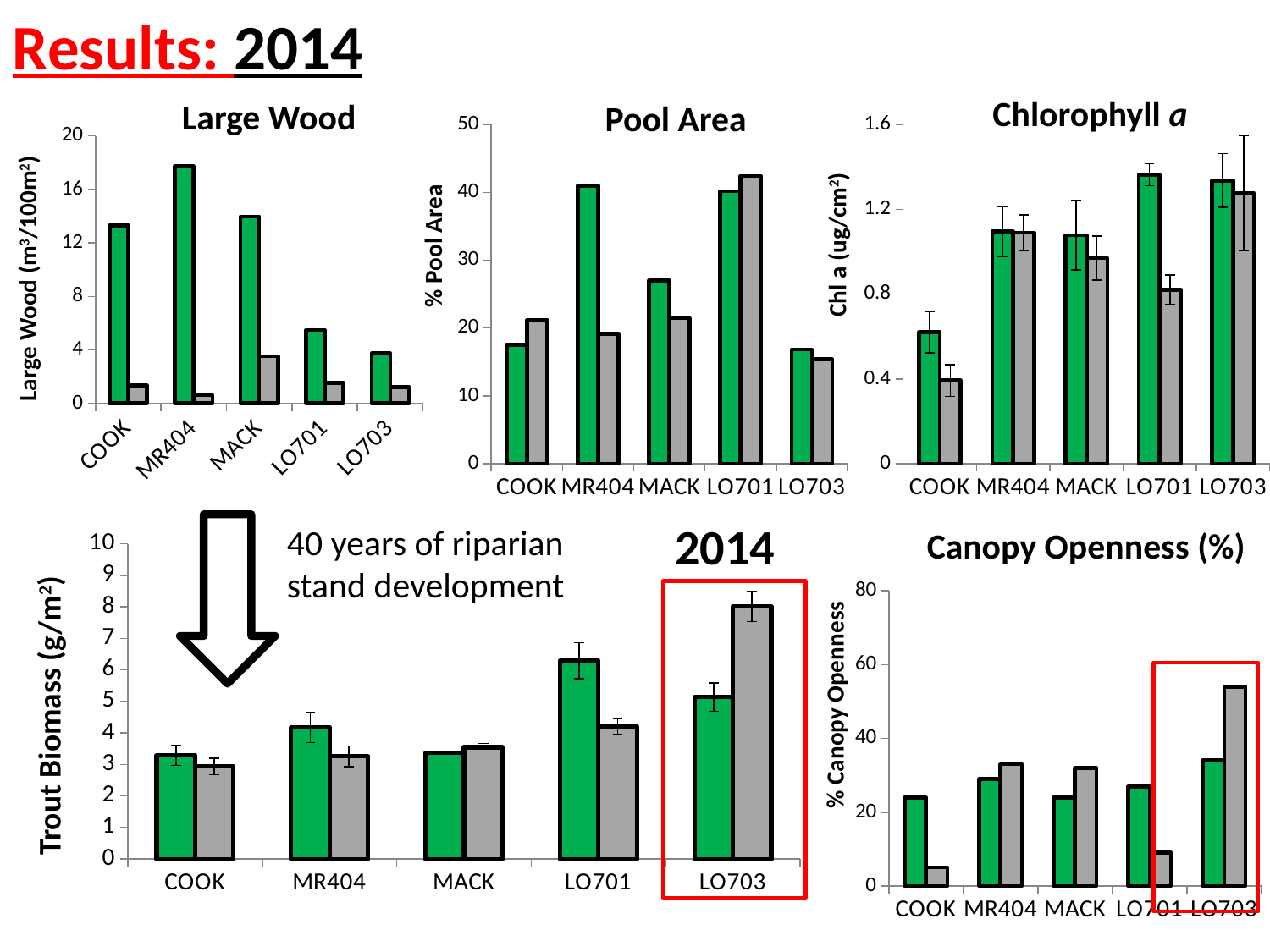
In the Canopy Openness (%) chart, which category has the lowest gray bar? COOK In the Canopy Openness (%) chart, is the gray bar for LO703 greater or less than 40? greater In the Large Wood chart, how many categories are shown on the x axis? 5 In the Chlorophyll a chart, is the green bar for LO701 greater or less than 1.2? greater In the Trout Biomass chart at the bottom left, for LO703, is the green bar or the gray bar taller? gray In the Pool Area chart, is the green bar for MACK greater or less than 20? greater In the Pool Area chart, which category has the tallest gray bar? LO701 In the Large Wood chart, which category has the tallest green bar? MR404 What kind of chart is the Pool Area chart? bar chart In the Chlorophyll a chart, which category has the lowest green bar? COOK In the Trout Biomass chart at the bottom left, which category has the tallest gray bar? LO703